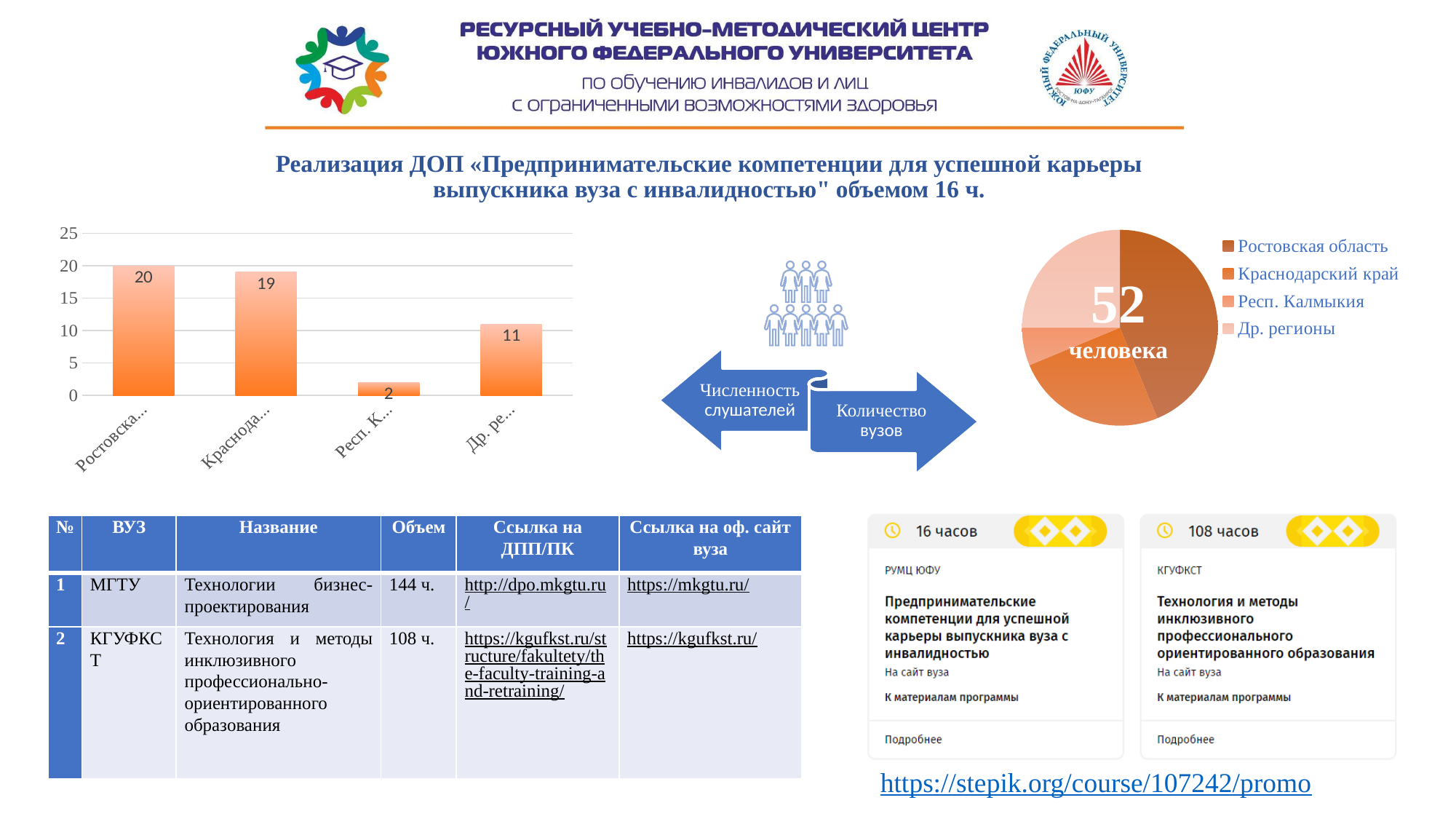
In the bar chart on the left, what is the value for the category Др. ре...? 11 In the bar chart on the left, what is the value for the first category (Ростовска...)? 20 In the bar chart on the left, which category has the highest value? Ростовска... In the pie chart on the right, how many entries does the legend list? 4 In the bar chart on the left, how many categories are shown? 4 In the bar chart on the left, what is the value for the category Респ. К...? 2 In the bar chart on the left, what is the difference between the values for Ростовска... and Др. ре...? 9 What type of chart is the chart on the left of the slide? Bar chart In the bar chart on the left, which is larger: the value for Краснода... or the value for Др. ре...? Краснода... In the bar chart on the left, what is the value for the category Краснода...? 19 What text is shown in the centre of the pie chart on the right? 52 человека In the bar chart on the left, which category has the lowest value? Респ. К...